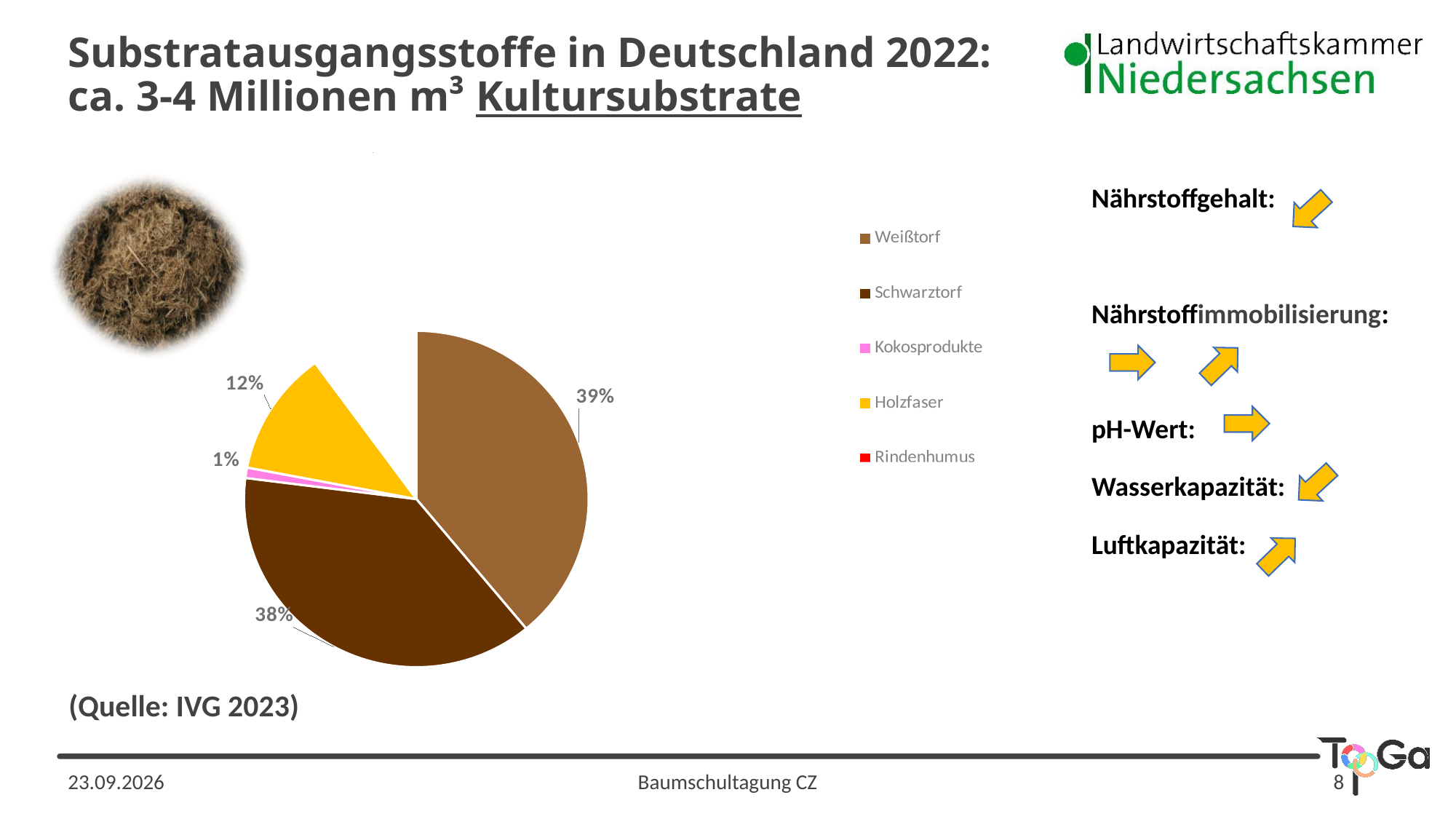
What is the combined share of Weißtorf and Schwarztorf? 77% How many categories are listed in the chart's legend? 5 What percentage share does Kokosprodukte have in the pie chart? 1% What is the difference between the Holzfaser share and the Kokosprodukte share? 11% Which has the larger share, Holzfaser or Kokosprodukte? Holzfaser What type of chart is shown on the slide? Pie chart By how many percentage points does the Weißtorf share exceed the Schwarztorf share? 1% What colour represents Holzfaser in the pie chart? Yellow What percentage share does Weißtorf have in the pie chart? 39% Which category has the largest slice in the pie chart? Weißtorf What percentage share does Holzfaser have in the pie chart? 12% What percentage share does Schwarztorf have in the pie chart? 38%